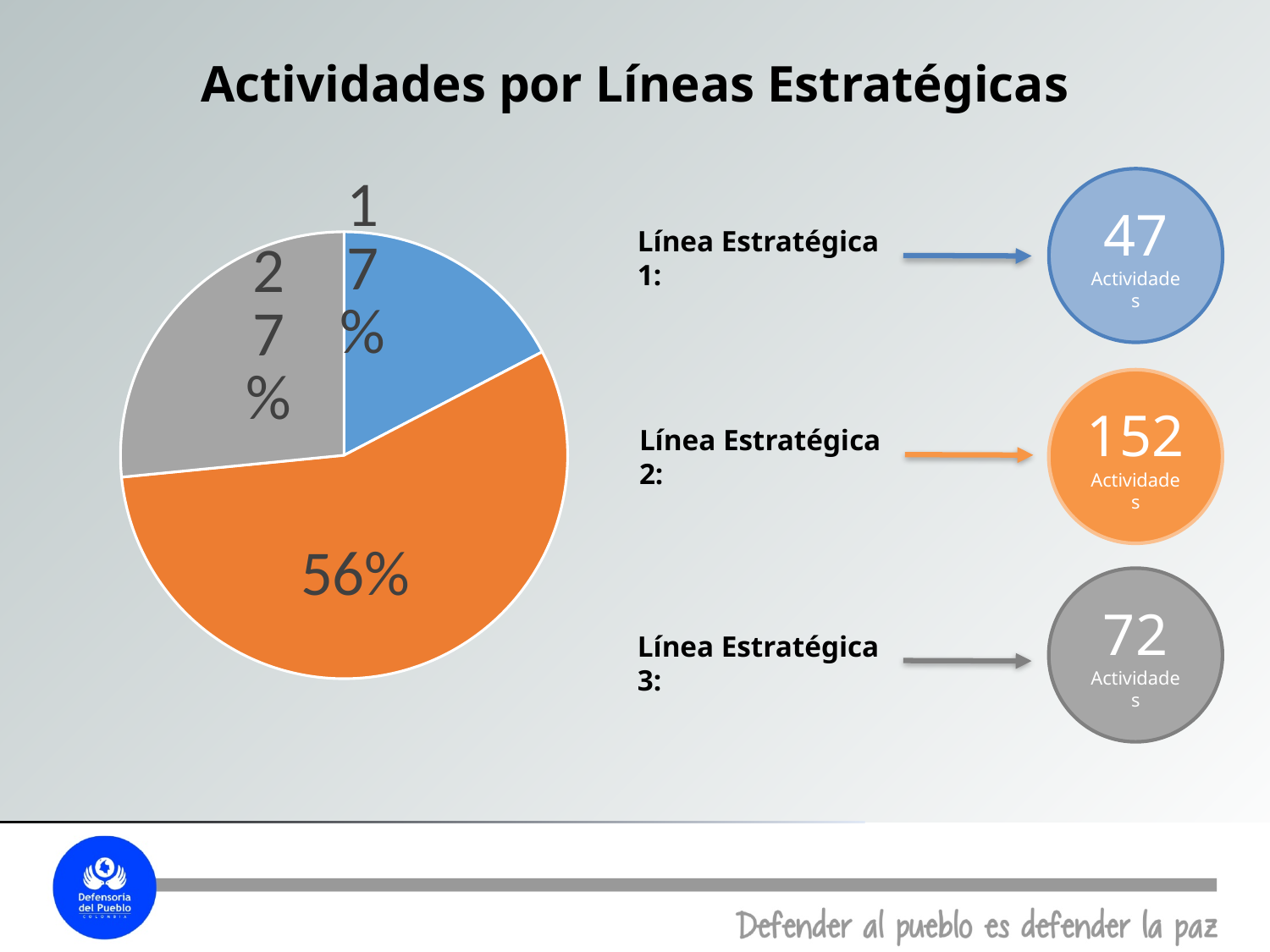
What share of the pie does the gray slice (Línea Estratégica 3) represent? 27% What is the difference in percentage points between the gray slice (27%) and the blue slice (17%)? 10 Which strategic line has the smallest slice of the pie? Línea Estratégica 1 How many slices does the pie chart have? 3 What share of the pie does the orange slice (Línea Estratégica 2) represent? 56% Which slice is larger, the gray one (Línea Estratégica 3) or the blue one (Línea Estratégica 1)? gray (Línea Estratégica 3) What colour is the slice representing Línea Estratégica 2? orange What share of the pie does the blue slice (Línea Estratégica 1) represent? 17% What is the difference in percentage points between the orange slice (56%) and the gray slice (27%)? 29 What is the title of the slide containing the pie chart? Actividades por Líneas Estratégicas What kind of chart is shown on the slide? pie chart Which strategic line has the largest slice of the pie? Línea Estratégica 2